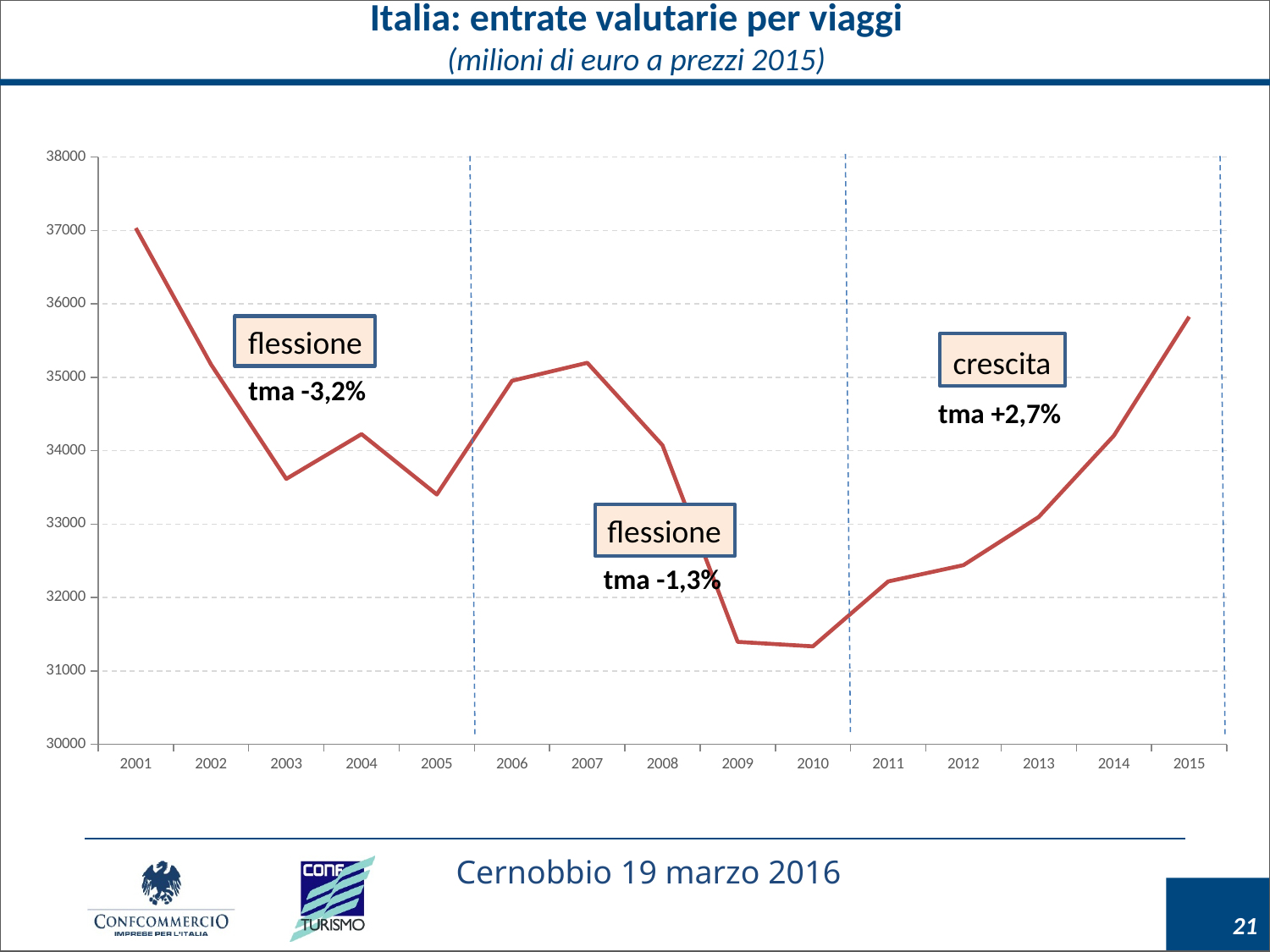
Is the value for 2003 greater or less than 34000? less Is the value for 2009 greater or less than 32000? less Do the values rise or fall from 2010 to 2015? rise Is the value for 2012 greater or less than 33000? less What kind of chart is shown on the slide? line chart Which year has the highest value in the chart? 2001 What average annual rate (tma) is shown for the 'crescita' period? tma +2,7% Which is larger, the value for 2007 or the value for 2004? 2007 Which is larger, the value for 2001 or the value for 2015? 2001 How many years are plotted on the x axis of the chart? 15